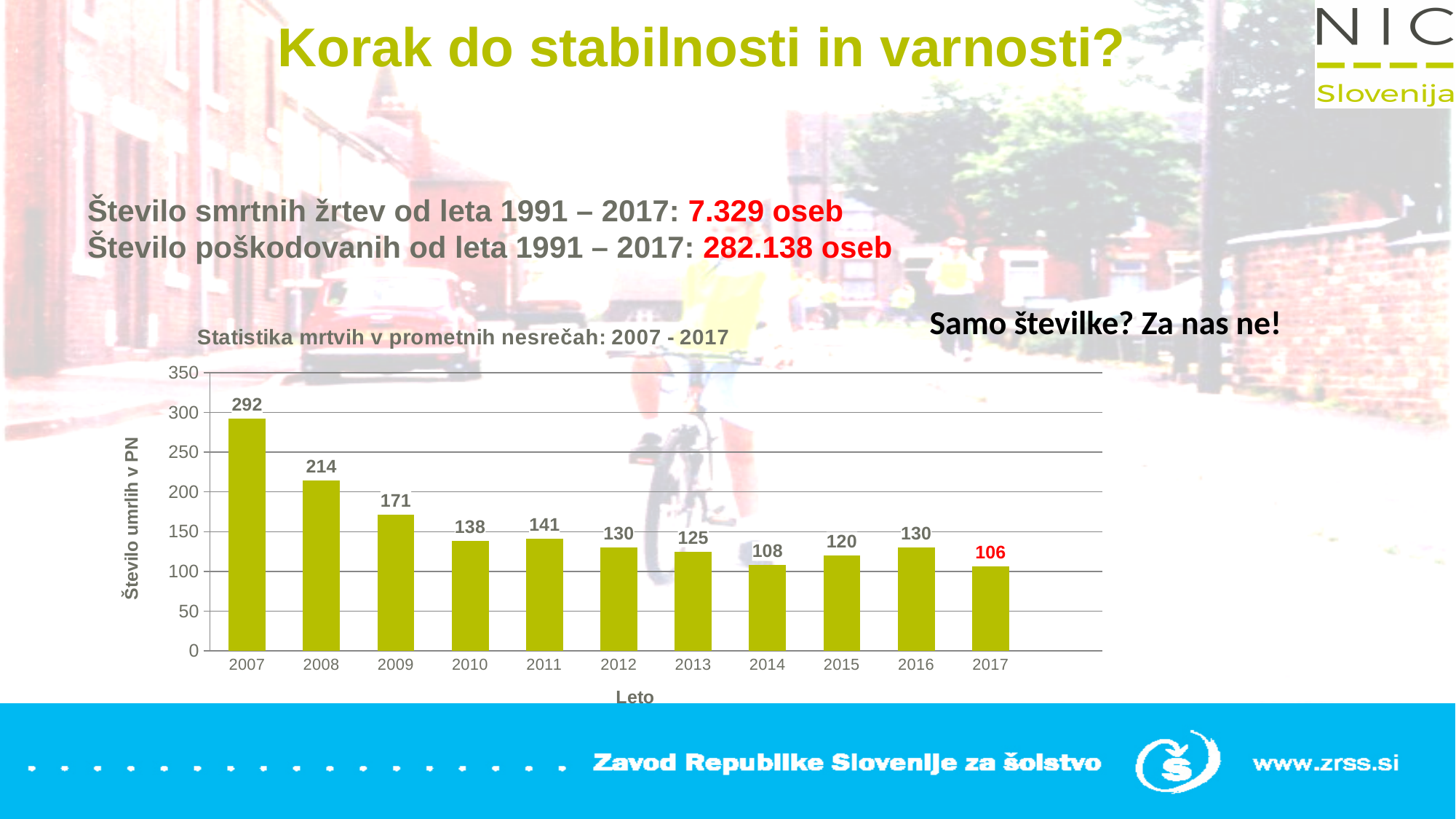
What is the title of the chart? Statistika mrtvih v prometnih nesrečah: 2007 - 2017 Which year has the highest value? 2007 Which is larger, the value for 2010 or the value for 2011? 2011 What is the value for 2014? 108 What is the difference between the values for 2007 and 2008? 78 What is the value for 2007? 292 What is the value for 2017? 106 Is the value for 2009 greater or less than 150? greater What kind of chart is shown? bar chart How many years are shown on the x axis? 11 What is the difference between the values for 2016 and 2017? 24 Which year has the lowest value? 2017